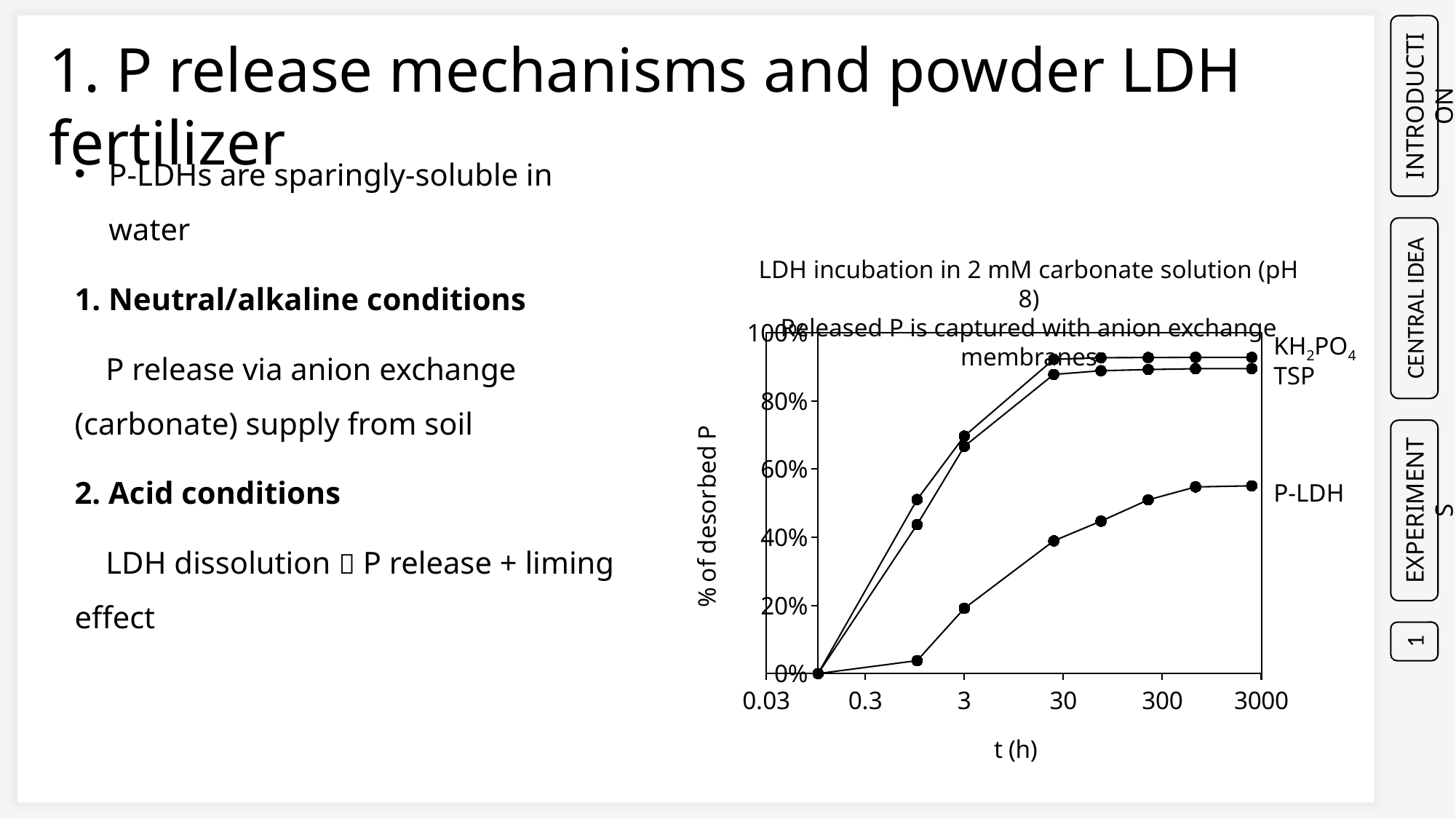
What is the title of the chart? LDH incubation in 2 mM carbonate solution (pH 8) How many series are plotted in the chart? 3 Is the value for KH2PO4 at 3000 h greater or less than 80%? greater What kind of chart is shown on the slide? line chart Is the value for TSP at 3 h greater or less than 60%? greater What is the label of the y axis of the chart? % of desorbed P Does the % of desorbed P for P-LDH rise or fall as t (h) increases? rise Which series has the lowest % of desorbed P at 3000 h? P-LDH Is the value for P-LDH at 3000 h greater or less than 60%? less At 3 h, which series has the larger % of desorbed P, TSP or P-LDH? TSP At 3000 h, which series has the larger % of desorbed P, KH2PO4 or P-LDH? KH2PO4